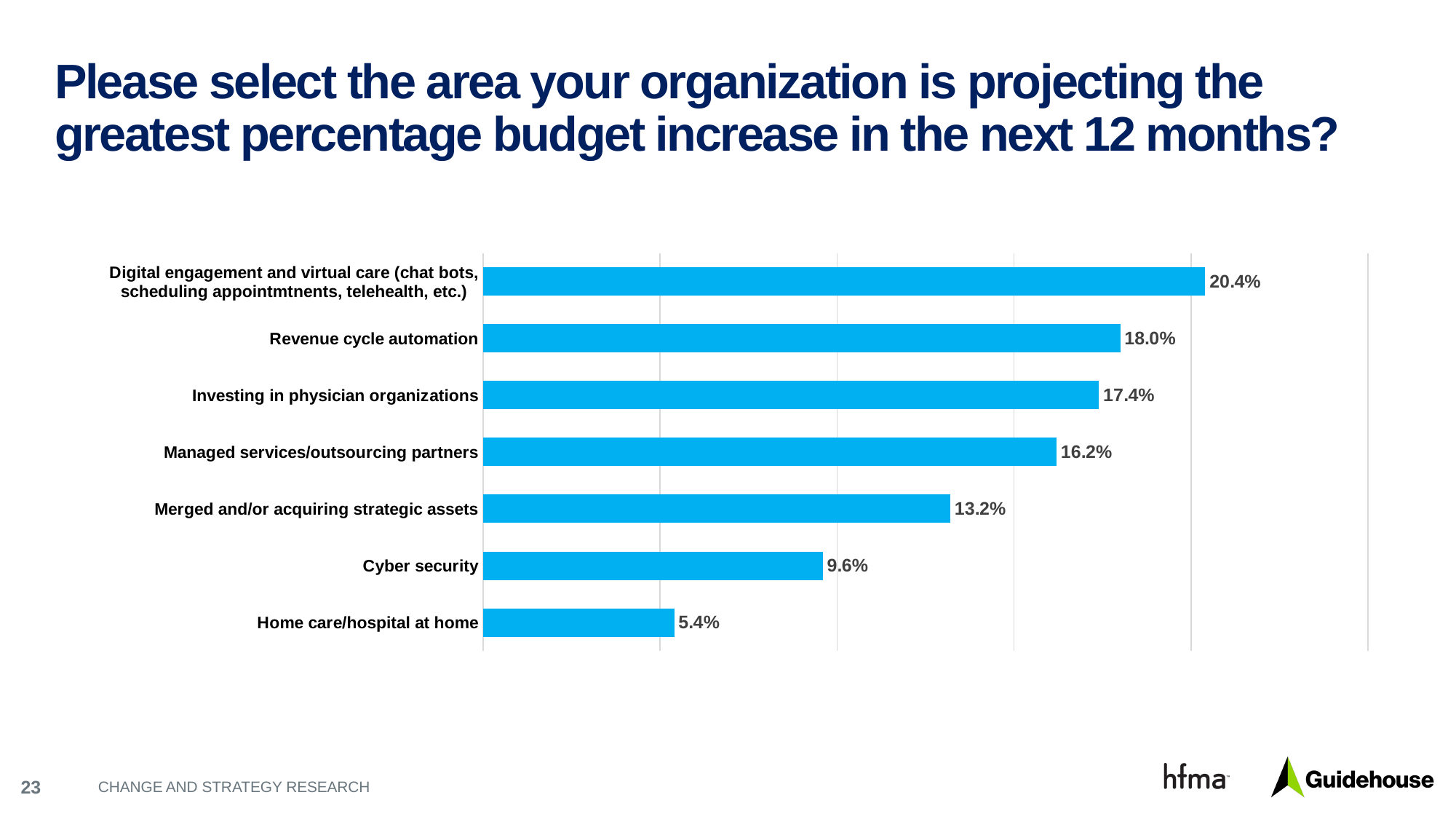
What is the difference between the values for Cyber security and Home care/hospital at home? 4.2% What is the difference between the values for Revenue cycle automation and Investing in physician organizations? 0.6% What is the value for Cyber security? 9.6% What colour are the bars in the chart? Blue What is the value for Merged and/or acquiring strategic assets? 13.2% Which area has the lowest percentage? Home care/hospital at home Which area has the highest percentage? Digital engagement and virtual care (chat bots, scheduling appointmtnents, telehealth, etc.) Which is larger, the value for Merged and/or acquiring strategic assets or the value for Cyber security? Merged and/or acquiring strategic assets How many areas are shown in the chart? 7 What kind of chart is shown on the slide? Bar chart What percentage is shown for Revenue cycle automation? 18.0% What percentage is shown for Managed services/outsourcing partners? 16.2%